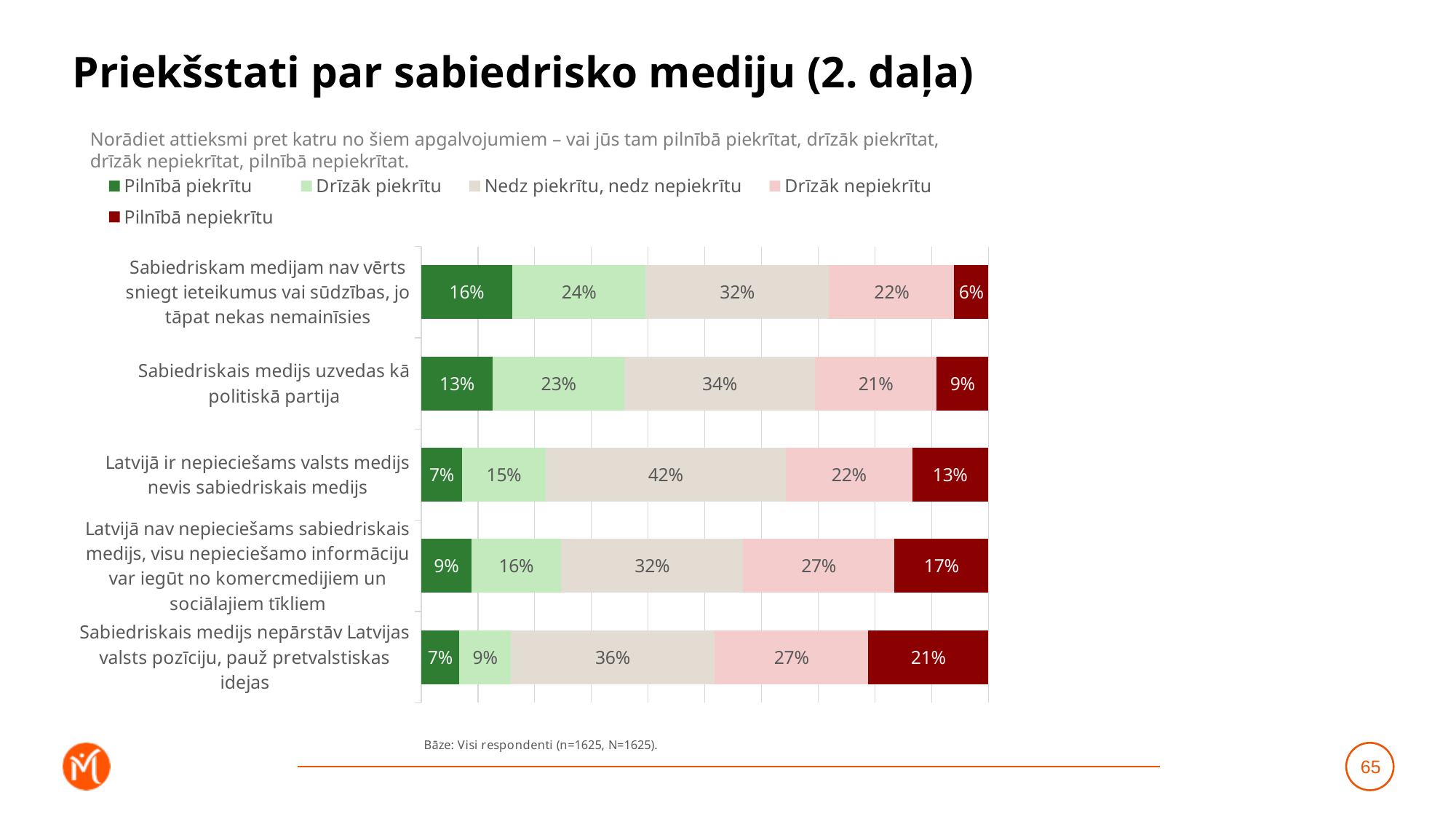
How many series does the legend list? 5 Which statement has the highest 'Pilnībā piekrītu' value? Sabiedriskam medijam nav vērts sniegt ieteikumus vai sūdzības, jo tāpat nekas nemainīsies What is the 'Pilnībā nepiekrītu' value for 'Sabiedriskais medijs nepārstāv Latvijas valsts pozīciju, pauž pretvalstiskas idejas'? 21% What is the 'Nedz piekrītu, nedz nepiekrītu' value for 'Latvijā ir nepieciešams valsts medijs nevis sabiedriskais medijs'? 42% What kind of chart is shown on the slide? Stacked bar chart What is the 'Pilnībā piekrītu' value for 'Sabiedriskais medijs uzvedas kā politiskā partija'? 13% Which statement has the lowest 'Pilnībā nepiekrītu' value? Sabiedriskam medijam nav vērts sniegt ieteikumus vai sūdzības, jo tāpat nekas nemainīsies How many statements (categories) are plotted in the chart? 5 What is the combined total of 'Pilnībā piekrītu' and 'Drīzāk piekrītu' for 'Latvijā ir nepieciešams valsts medijs nevis sabiedriskais medijs'? 22% Which is larger: the 'Drīzāk piekrītu' value for 'Sabiedriskam medijam nav vērts sniegt ieteikumus vai sūdzības, jo tāpat nekas nemainīsies' or for 'Sabiedriskais medijs nepārstāv Latvijas valsts pozīciju, pauž pretvalstiskas idejas'? Sabiedriskam medijam nav vērts sniegt ieteikumus vai sūdzības, jo tāpat nekas nemainīsies Which legend entry is shown in dark red? Pilnībā nepiekrītu What is the difference between the 'Drīzāk nepiekrītu' value for 'Latvijā nav nepieciešams sabiedriskais medijs, visu nepieciešamo informāciju var iegūt no komercmedijiem un sociālajiem tīkliem' and for 'Sabiedriskais medijs uzvedas kā politiskā partija'? 6%